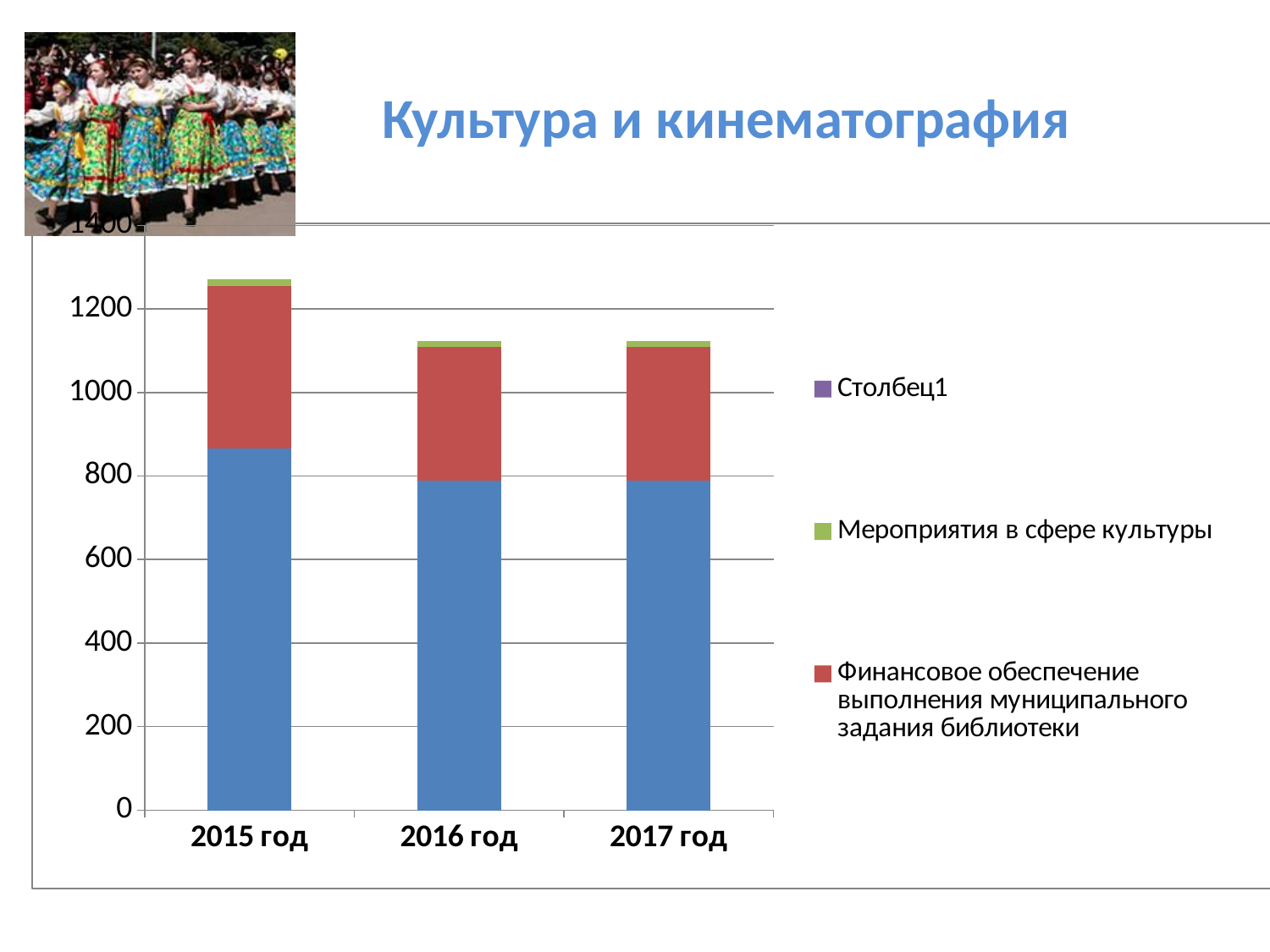
What is the title of the slide containing the chart? Культура и кинематография What kind of chart is shown on the slide? Stacked bar chart Which stacked bar is taller, 2015 год or 2016 год? 2015 год Which legend entry is shown in green? Мероприятия в сфере культуры Which year has the tallest stacked bar in the chart? 2015 год Does the total bar height rise or fall from 2015 год to 2016 год? fall Is the total height of the stacked bar for 2016 год greater or less than 1200? less Is the blue segment for 2015 год greater or less than 800? greater How many year categories are shown on the x axis of the chart? 3 Is the total height of the stacked bar for 2015 год greater or less than 1200? greater How many series does the chart legend list? 3